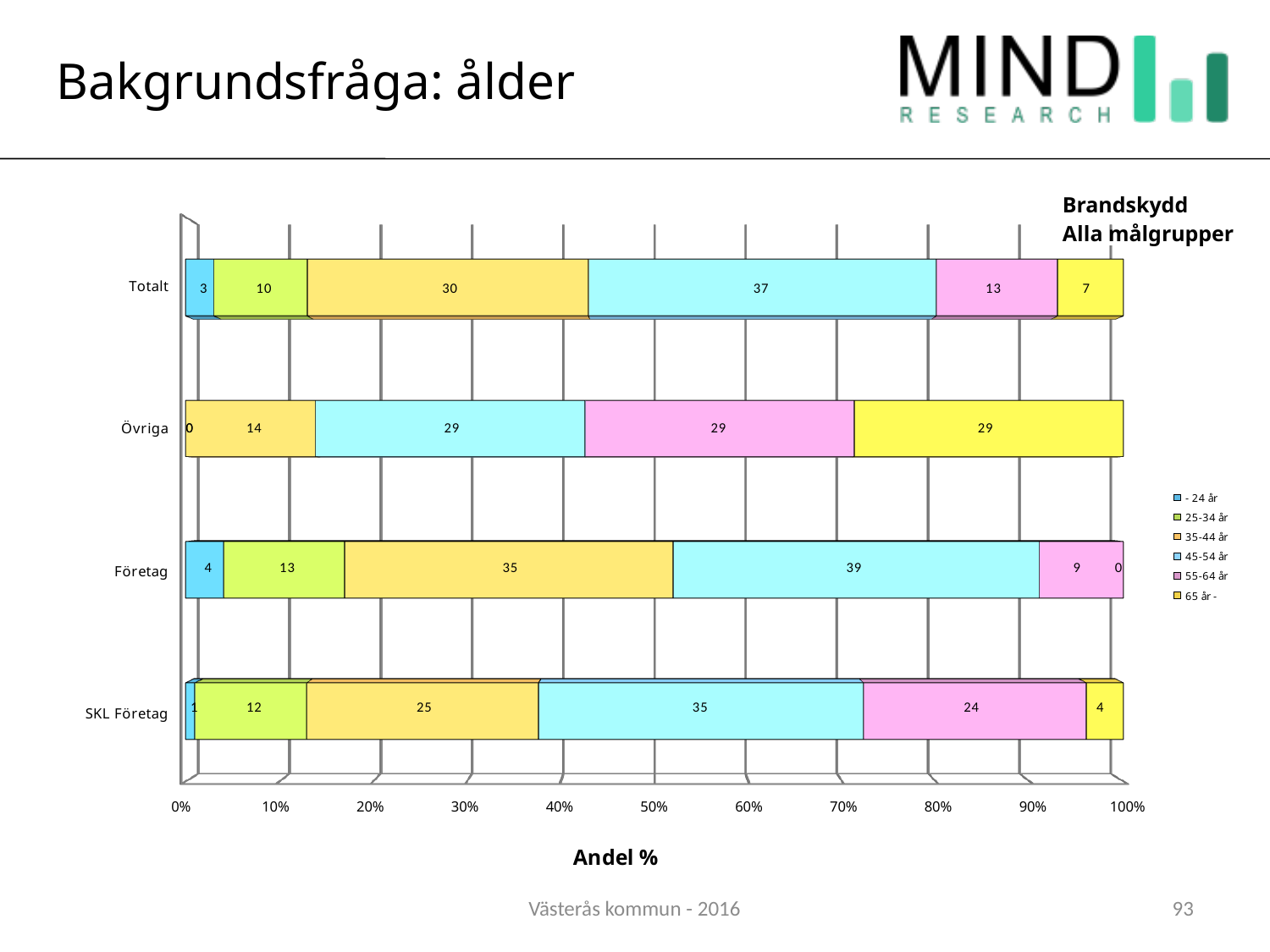
What is the value of the 55-64 år segment for SKL Företag? 24 What is the value of the 35-44 år segment for Företag? 35 What is the label of the horizontal axis? Andel % How many categories are plotted on the vertical axis? 4 Which is larger: the 25-34 år value for Företag or for SKL Företag? Företag What kind of chart is shown on the slide? Stacked bar chart What is the difference between the 35-44 år values for Företag and SKL Företag? 10 How many series does the legend list? 6 Which category has the highest value for the 45-54 år series? Företag Which category has the lowest value for the 65 år - series? Företag What is the value of the 45-54 år segment for Totalt? 37 What is the value of the 65 år - segment for Övriga? 29